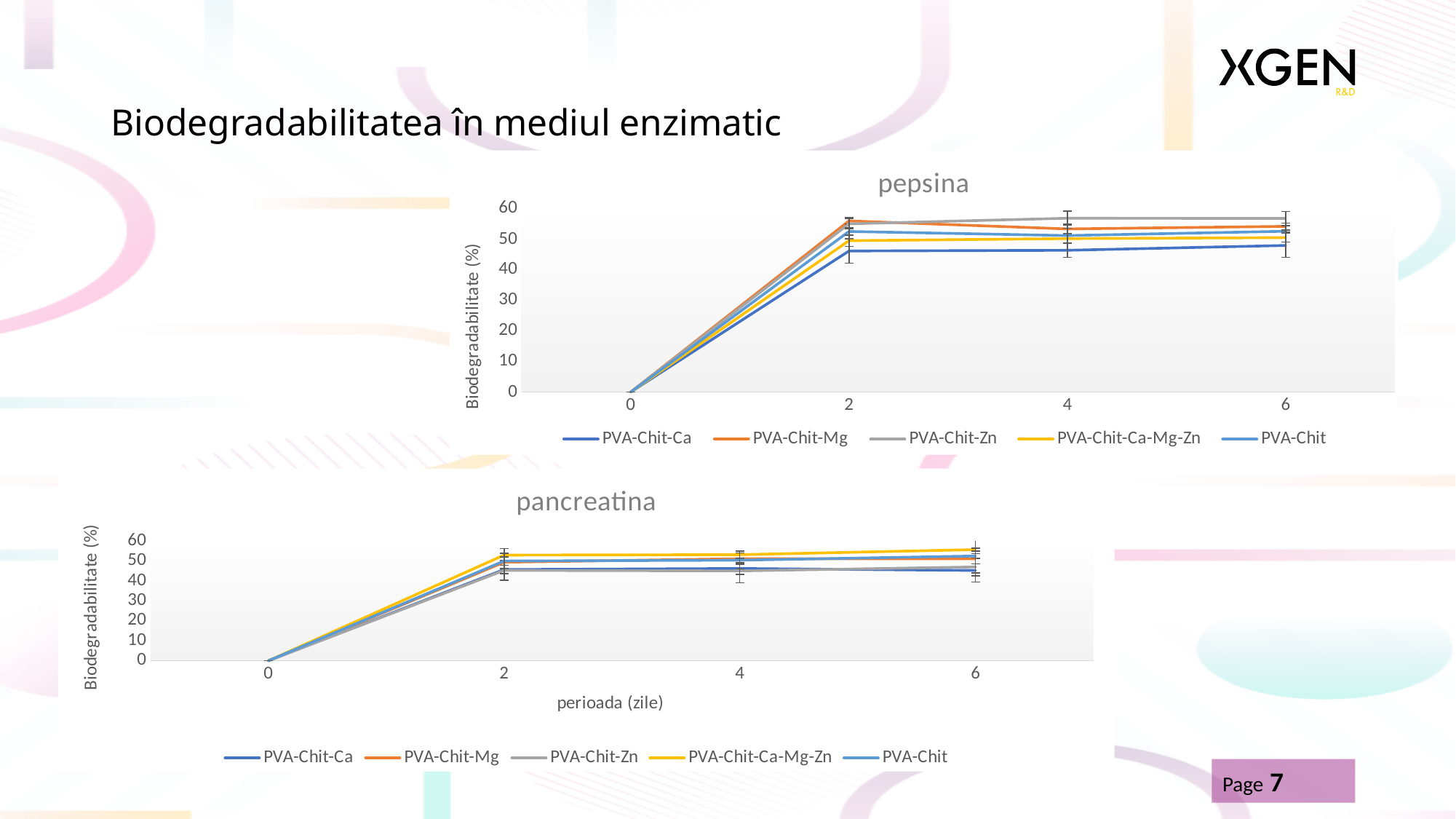
In the "pepsina" chart, which series has the highest value at day 6? PVA-Chit-Zn In the "pancreatina" chart, do the values rise or fall between day 0 and day 2? rise In the "pepsina" chart, is the value for PVA-Chit-Ca at day 2 greater or less than 50? less What is the x-axis label of the "pancreatina" chart? perioada (zile) In the "pepsina" chart, what is the value of PVA-Chit-Ca at day 0? 0 How many time points are plotted along the x axis of the "pepsina" chart? 4 In the "pepsina" chart, is the value for PVA-Chit-Zn at day 6 greater or less than 50? greater How many series does the legend of the "pancreatina" chart list? 5 In the "pancreatina" chart, which series has the highest value at day 6? PVA-Chit-Ca-Mg-Zn In the "pepsina" chart, which series has the lowest value at day 6? PVA-Chit-Ca What type of chart is the "pepsina" chart? line chart In the "pancreatina" chart, is the value for PVA-Chit-Zn at day 2 greater or less than 50? less